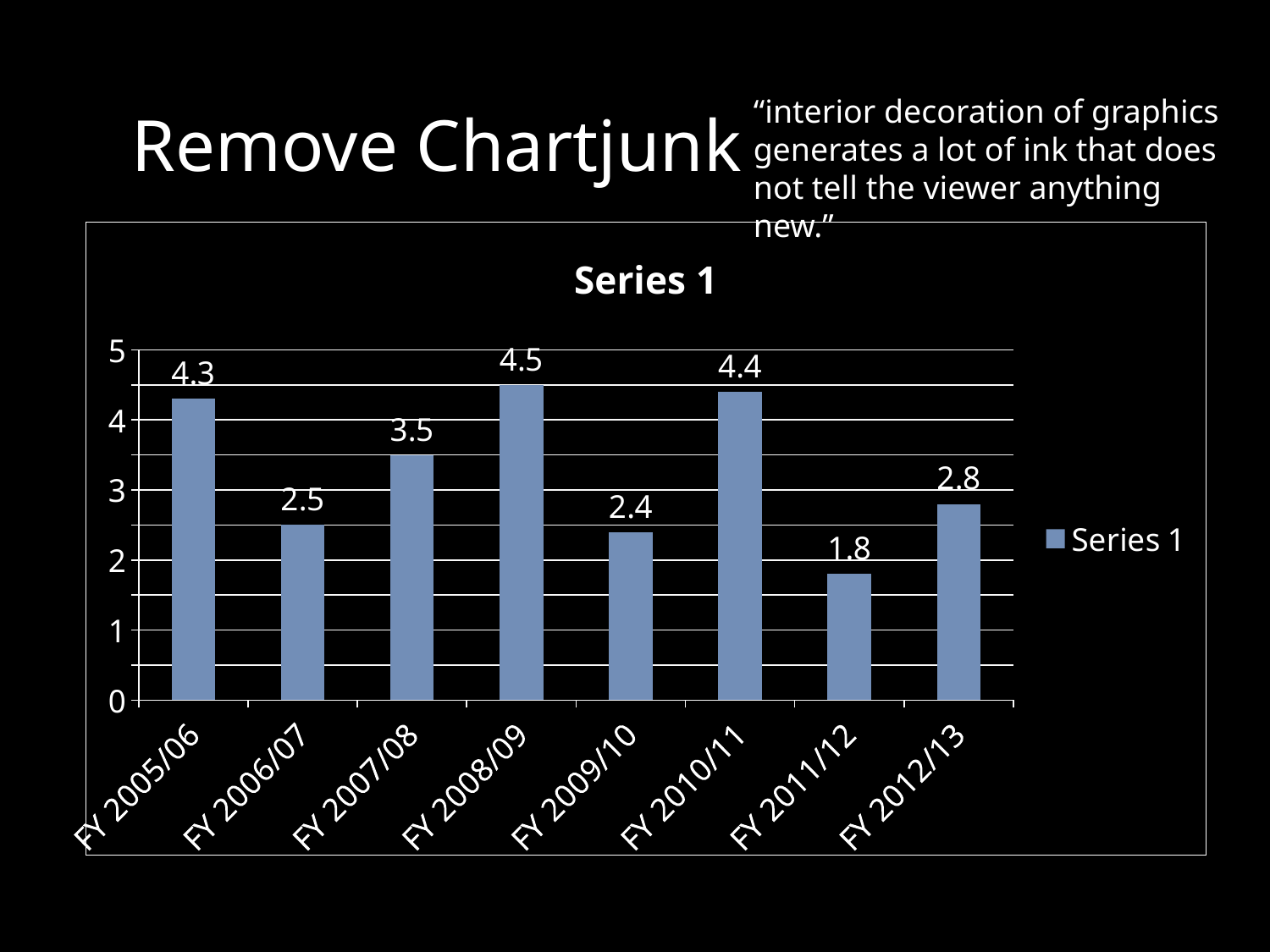
Which fiscal year has the lowest value? FY 2011/12 What kind of chart is shown on the slide? bar chart How many fiscal years are shown on the x axis? 8 What is the difference between the values for FY 2008/09 and FY 2011/12? 2.7 What is the value for FY 2005/06? 4.3 Which fiscal year has the highest value? FY 2008/09 What is the difference between the values for FY 2007/08 and FY 2006/07? 1 How many series does the legend list? 1 What is the value for FY 2012/13? 2.8 What is the value for FY 2009/10? 2.4 Which is larger, the value for FY 2010/11 or the value for FY 2012/13? FY 2010/11 What is the title of the chart? Series 1